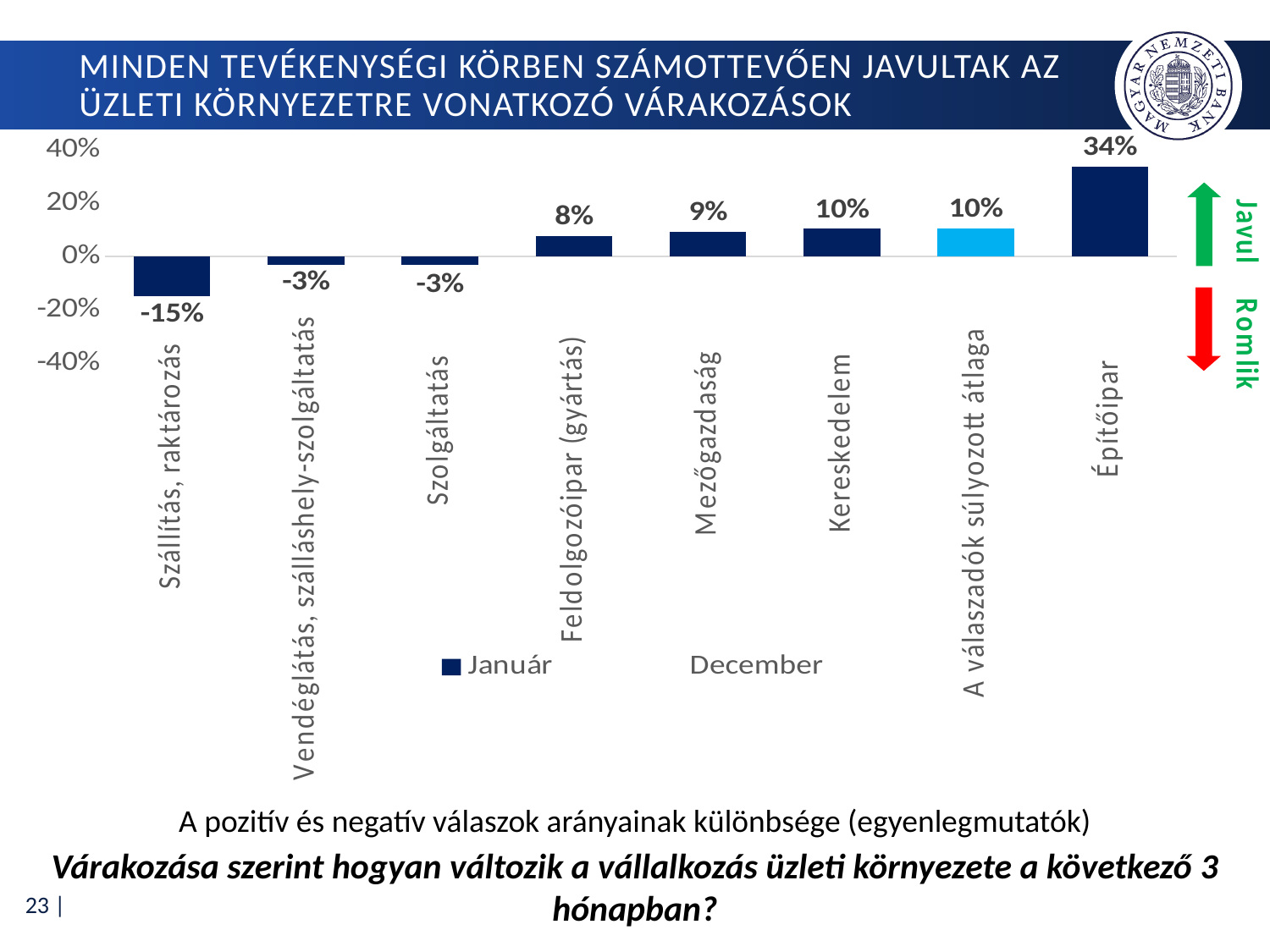
What is the difference between the values for Építőipar and Kereskedelem? 24% What is the value for Szállítás, raktározás? -15% Is the value for Építőipar greater or less than 20%? greater Which category has the lowest value? Szállítás, raktározás What kind of chart is shown on the slide? bar chart Which is larger, the value for Feldolgozóipar (gyártás) or the value for Szállítás, raktározás? Feldolgozóipar (gyártás) What is the value for Mezőgazdaság? 9% What is the value for A válaszadók súlyozott átlaga? 10% Which category has the highest value? Építőipar What is the value for Építőipar? 34% How many categories are shown on the x axis? 8 How many entries does the legend list? 2